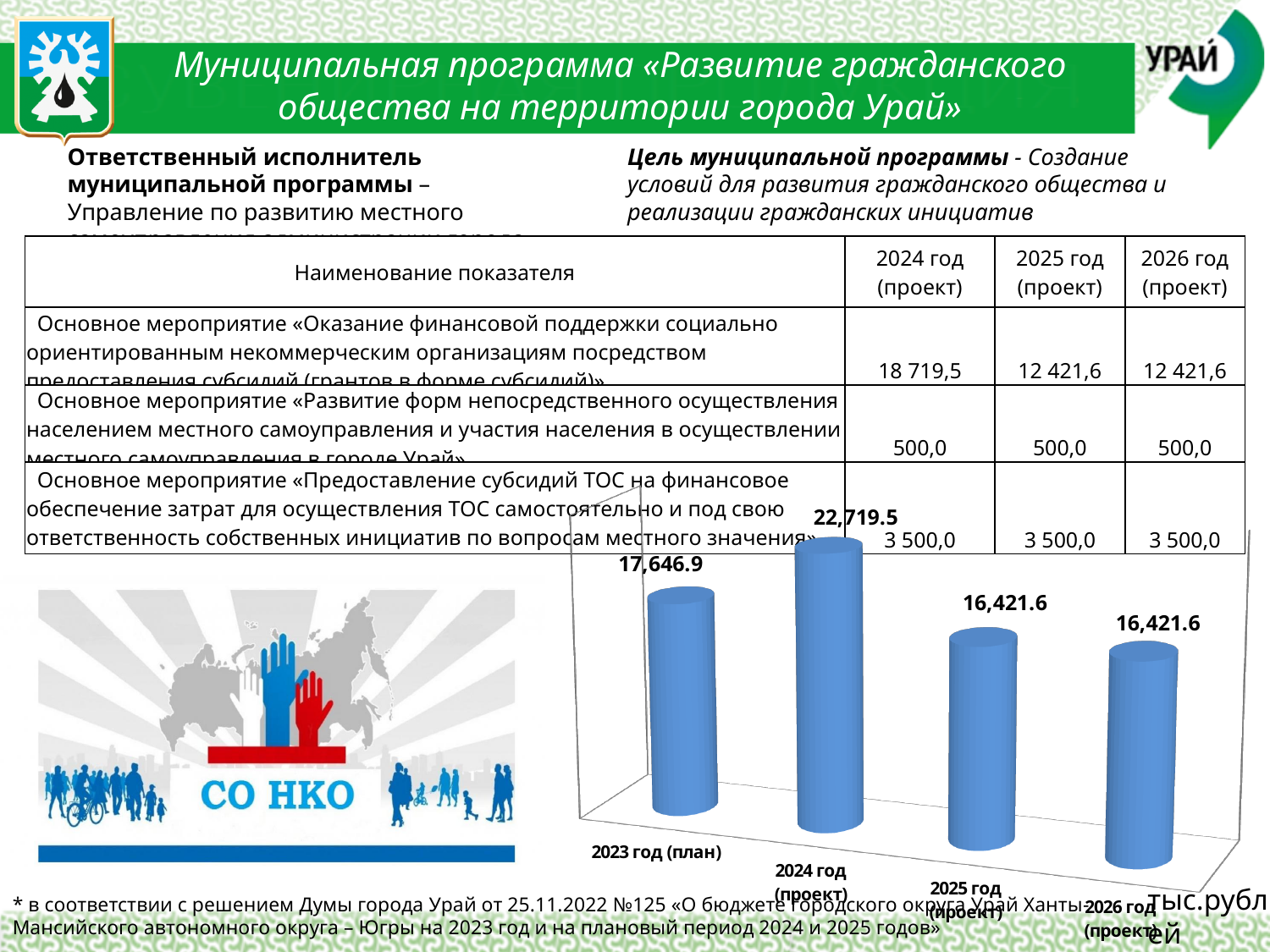
What unit is indicated for the chart values at the bottom right of the slide? тыс.рублей Which category has the highest value? 2024 год (проект) What is the value for 2023 год (план)? 17,646.9 How many bars (categories) does the chart show? 4 Which is larger, the value for 2023 год (план) or the value for 2025 год (проект)? 2023 год (план) What is the value for 2024 год (проект)? 22,719.5 What type of chart is shown on the slide? bar chart Do the values rise or fall from 2024 год (проект) to 2025 год (проект)? fall What is the value for 2026 год (проект)? 16,421.6 What is the difference between the values for 2024 год (проект) and 2023 год (план)? 5,072.6 What is the value for 2025 год (проект)? 16,421.6 What is the difference between the values for 2024 год (проект) and 2025 год (проект)? 6,297.9